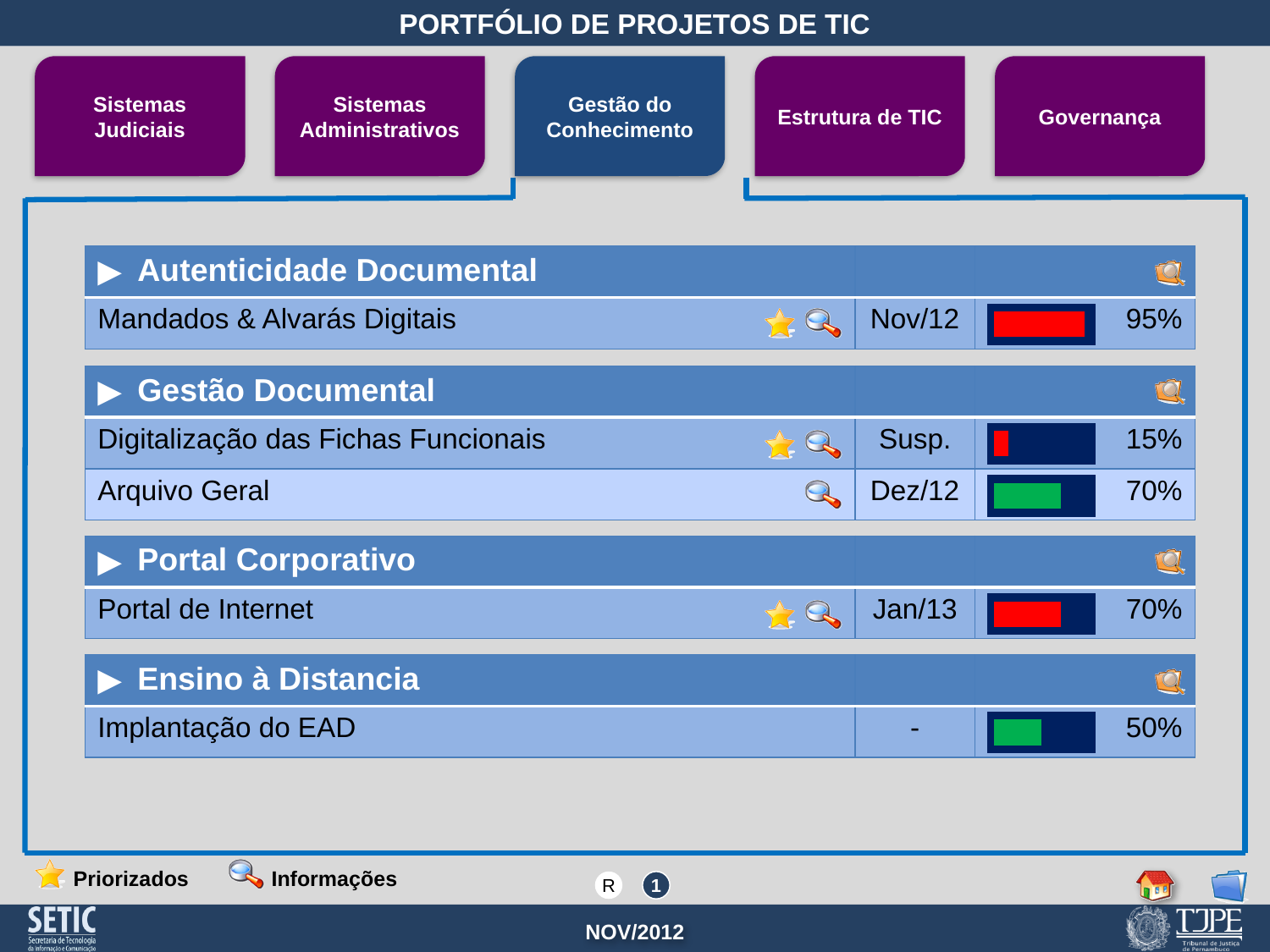
What is the difference in progress percentage between Arquivo Geral and Digitalização das Fichas Funcionais? 55% What date is shown next to Portal de Internet? Jan/13 What colour is the progress bar for Arquivo Geral? Green What is the progress percentage shown for Arquivo Geral? 70% Which project has the lowest progress percentage? Digitalização das Fichas Funcionais Which has a higher progress percentage, Portal de Internet or Implantação do EAD? Portal de Internet How many projects have a progress bar shown on the slide? 5 Which project has the highest progress percentage? Mandados & Alvarás Digitais What is the difference in progress percentage between Mandados & Alvarás Digitais and Implantação do EAD? 45% What is the progress percentage shown for Mandados & Alvarás Digitais? 95% What is the progress percentage shown for Implantação do EAD? 50% What is the progress percentage shown for Digitalização das Fichas Funcionais? 15%